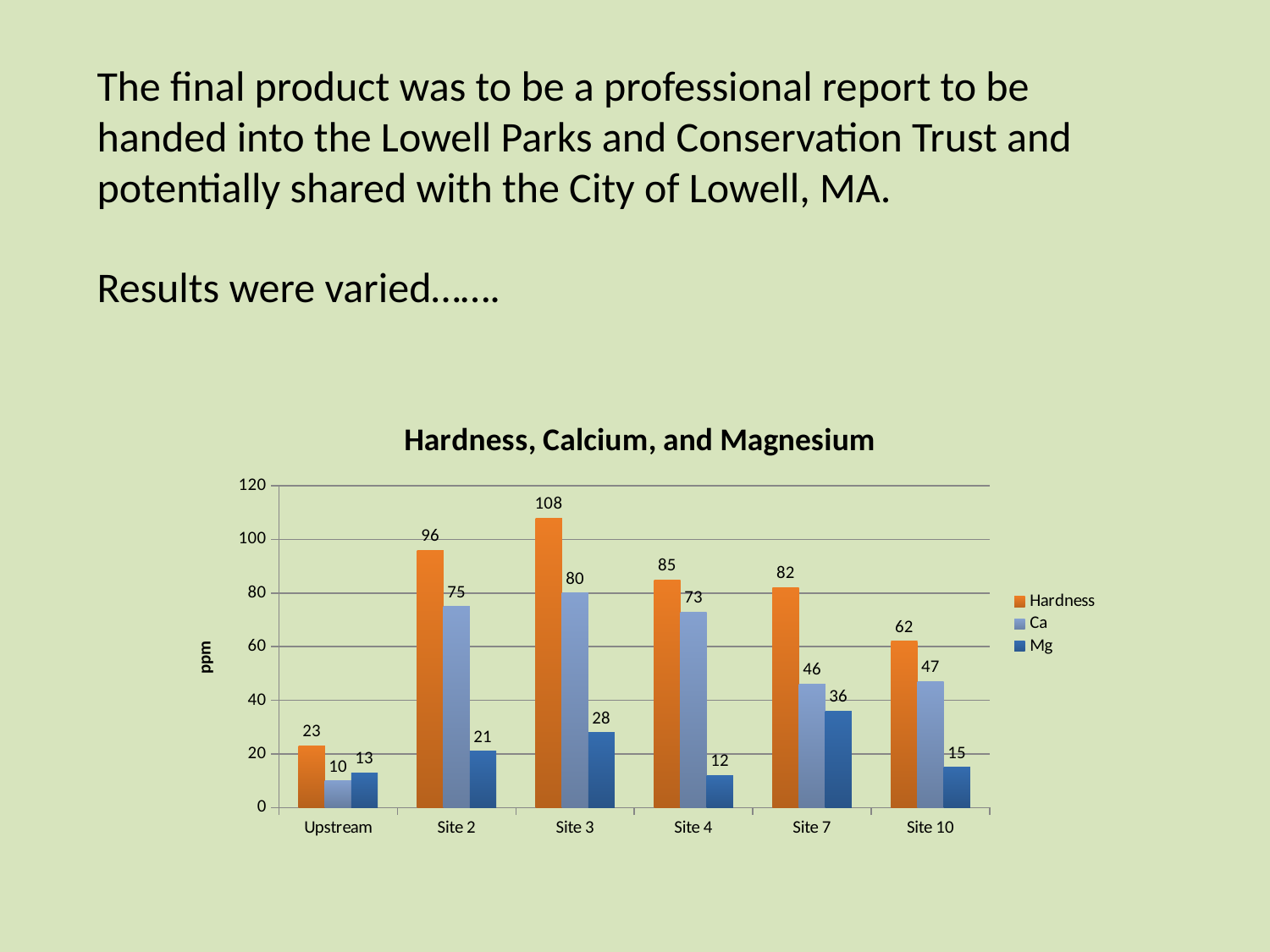
Which site has the lowest Ca value? Upstream What is the difference between the Hardness and Ca values at Site 2? 21 Is the Mg value larger at Site 7 or at Site 10? Site 7 How many series does the legend list? 3 What is the Ca value for Site 7? 46 What is the label on the y axis? ppm What is the title of the chart? Hardness, Calcium, and Magnesium What kind of chart is shown? Bar chart What is the Mg value for Upstream? 13 Which site has the highest Hardness value? Site 3 What is the Hardness value for Site 3? 108 How many sites are shown on the x axis? 6